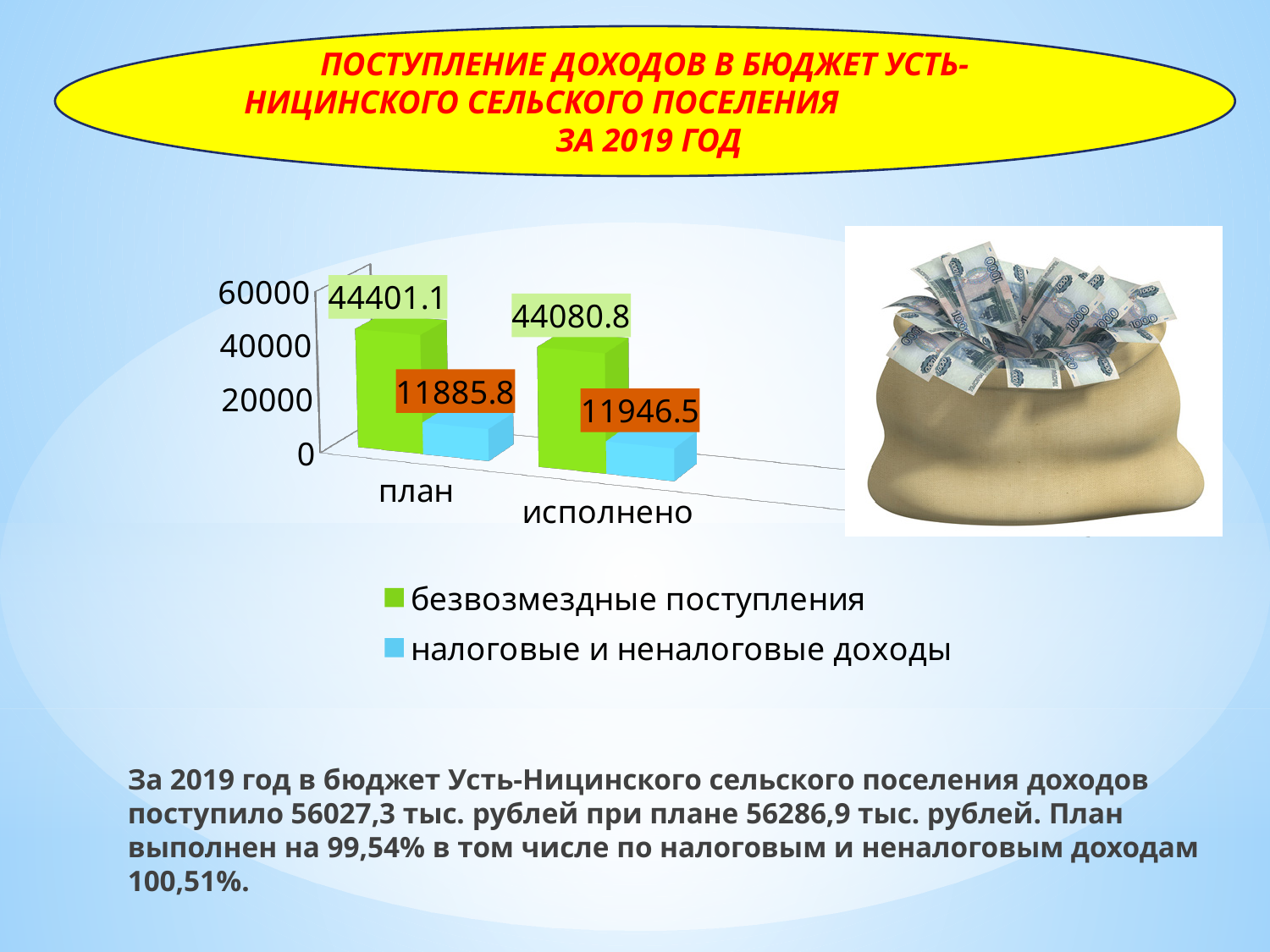
How many categories are shown on the x axis of the chart? 2 What is the difference between налоговые и неналоговые доходы for исполнено and for план? 60.7 How many series does the legend list? 2 Which is larger: безвозмездные поступления for план or for исполнено? план What kind of chart is shown on the slide? bar chart What is the value of безвозмездные поступления for исполнено? 44080.8 What is the value of налоговые и неналоговые доходы for план? 11885.8 What is the value of безвозмездные поступления for план? 44401.1 Which series has the highest value in the chart? безвозмездные поступления What is the difference between безвозмездные поступления for план and for исполнено? 320.3 What is the value of налоговые и неналоговые доходы for исполнено? 11946.5 Is the value of безвозмездные поступления for план greater or less than 40000? greater